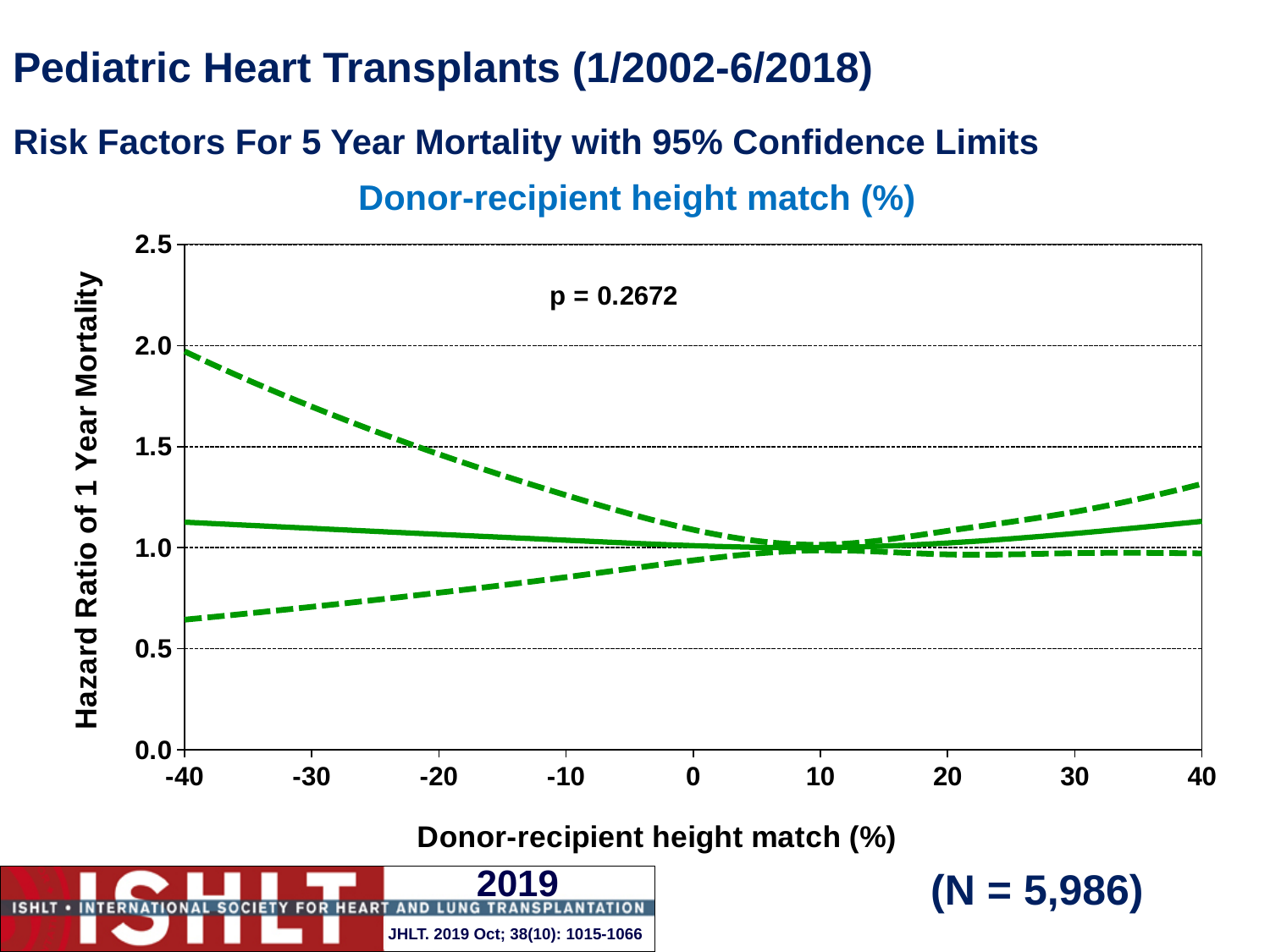
What kind of chart is shown on the slide? line chart What p-value is printed on the chart? p = 0.2672 Is the upper dashed confidence limit at a donor-recipient height match of 40 greater or less than 1.5? less Is the upper dashed confidence limit at a donor-recipient height match of -40 greater or less than 1.5? greater Is the lower dashed confidence limit at a donor-recipient height match of -40 greater or less than 1.0? less Is the upper dashed confidence limit higher at a donor-recipient height match of -40 or at 40? -40 How many lines are plotted on the chart? 3 Does the upper dashed confidence limit rise or fall as the donor-recipient height match goes from -40 to 10? fall How many tick labels are shown on the x axis (Donor-recipient height match)? 9 Does the lower dashed confidence limit rise or fall as the donor-recipient height match goes from -40 to 10? rise